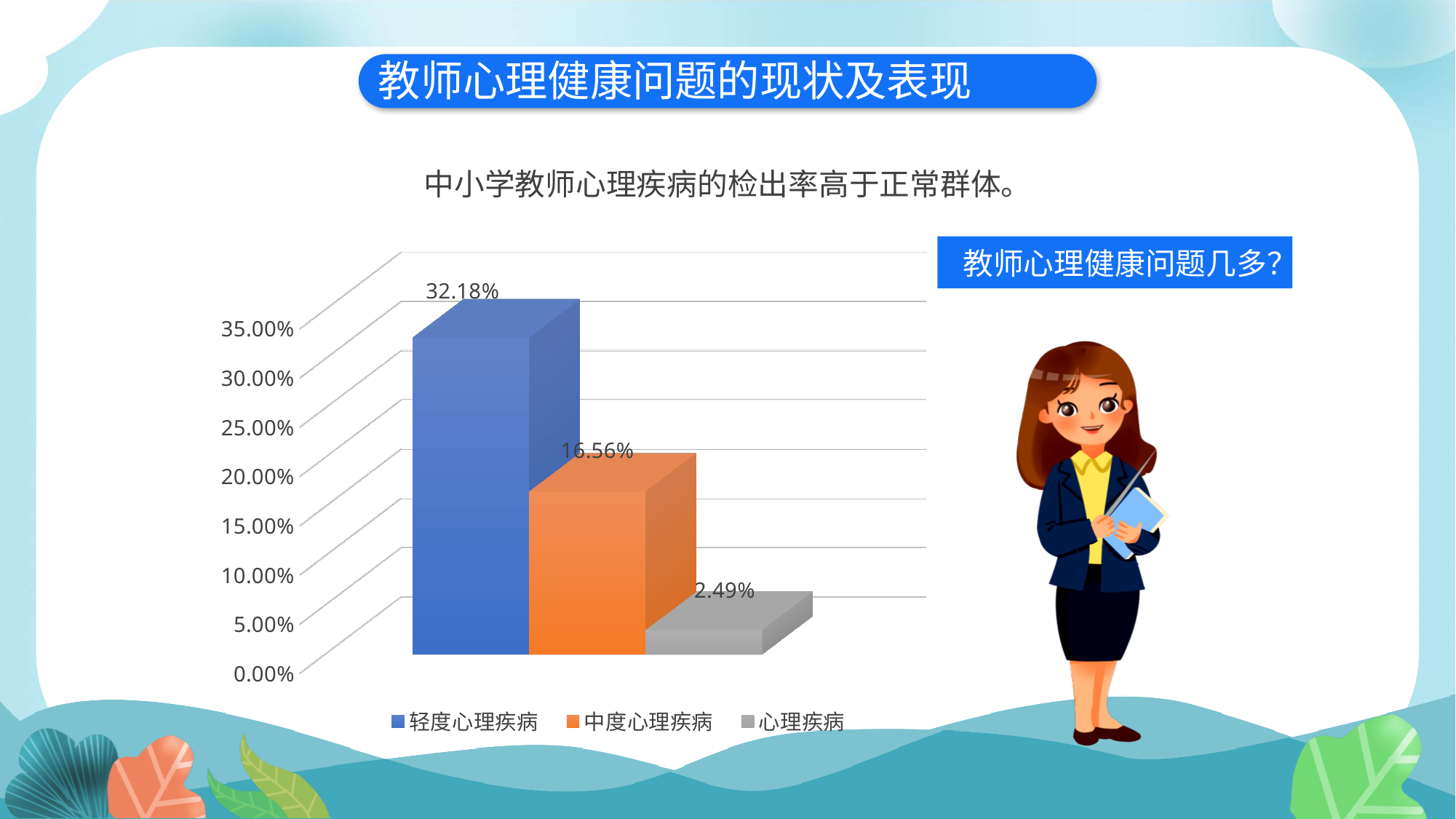
What colour is the bar for 中度心理疾病? orange Which series has the lowest value? 心理疾病 What is the difference between the values for 轻度心理疾病 and 中度心理疾病? 15.62% What is the value shown for 轻度心理疾病? 32.18% Which is larger, the value for 中度心理疾病 or the value for 心理疾病? 中度心理疾病 What kind of chart is shown on the slide? bar chart Is the value for 轻度心理疾病 greater or less than 30.00%? greater Which series has the highest value? 轻度心理疾病 What is the value shown for 中度心理疾病? 16.56% What is the difference between the values for 中度心理疾病 and 心理疾病? 14.07% What is the value shown for 心理疾病? 2.49% How many series does the legend list? 3